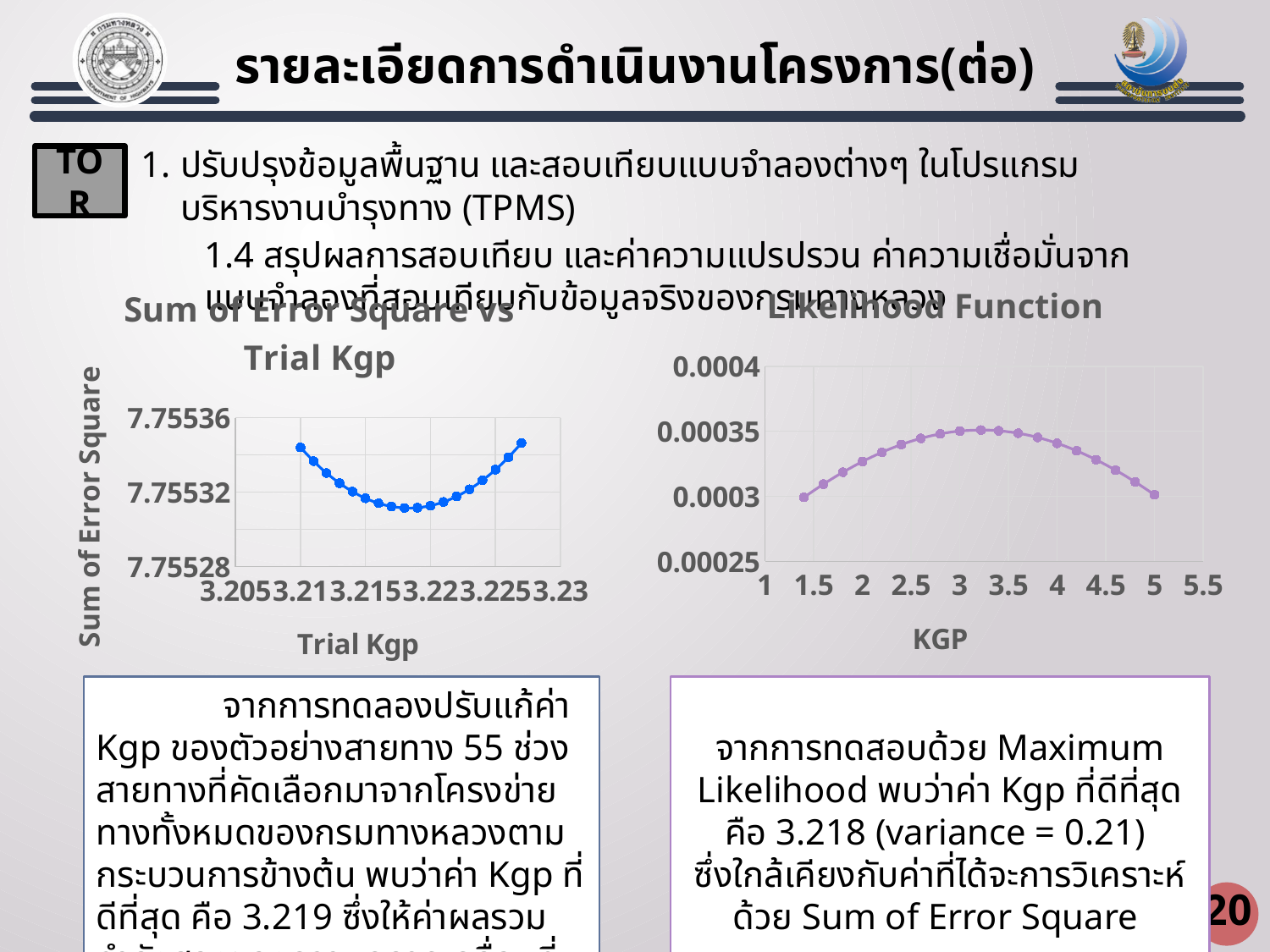
On the "Likelihood Function" chart, is the value at KGP 1.5 greater or less than 0.00035? less On the "Likelihood Function" chart, is the value at KGP 3.5 greater or less than 0.0003? greater On the "Likelihood Function" chart, do the values rise or fall as KGP increases from 3.5 to 5? fall On the "Likelihood Function" chart, which has the larger value: KGP 1.5 or KGP 3.5? 3.5 On the "Likelihood Function" chart, is the value at KGP 5 greater or less than 0.00035? less On the "Sum of Error Square vs Trial Kgp" chart, which has the larger value: Trial Kgp 3.21 or Trial Kgp 3.22? 3.21 What kind of chart is the "Sum of Error Square vs Trial Kgp" chart? line chart with markers What kind of chart is the "Likelihood Function" chart? line chart with markers On the "Sum of Error Square vs Trial Kgp" chart, what is the title of the vertical axis? Sum of Error Square On the "Likelihood Function" chart, what is the title of the horizontal axis? KGP